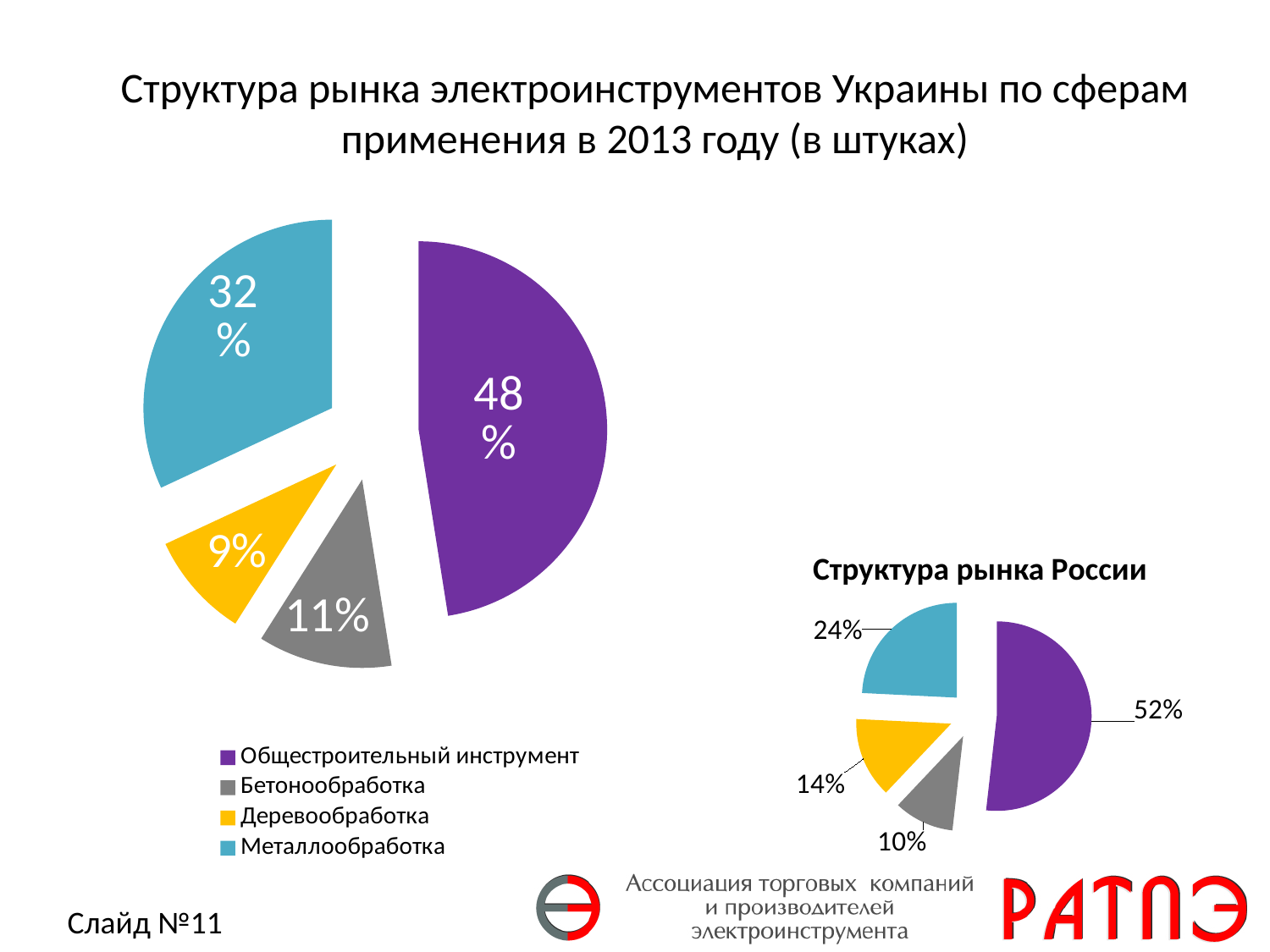
On the large pie chart for Ukraine, what share does Бетонообработка have? 11% On the large pie chart for Ukraine, what share does Деревообработка have? 9% On the large pie chart for Ukraine, what is the difference in percentage points between Общестроительный инструмент and Металлообработка? 16 On the chart titled Структура рынка России, what share does the purple slice (Общестроительный инструмент) have? 52% On the chart titled Структура рынка России, which is larger: the yellow slice (Деревообработка) or the gray slice (Бетонообработка)? Деревообработка On the large pie chart for Ukraine, what share does Общестроительный инструмент have? 48% On the large pie chart for Ukraine, which category has the smallest share? Деревообработка On the chart titled Структура рынка России, what share does the blue slice (Металлообработка) have? 24% What type of chart is used for the Ukraine market structure? Pie chart On the large pie chart for Ukraine, which category has the largest share? Общестроительный инструмент How many categories does the legend of the large pie chart for Ukraine list? 4 On the large pie chart for Ukraine, what share does Металлообработка have? 32%